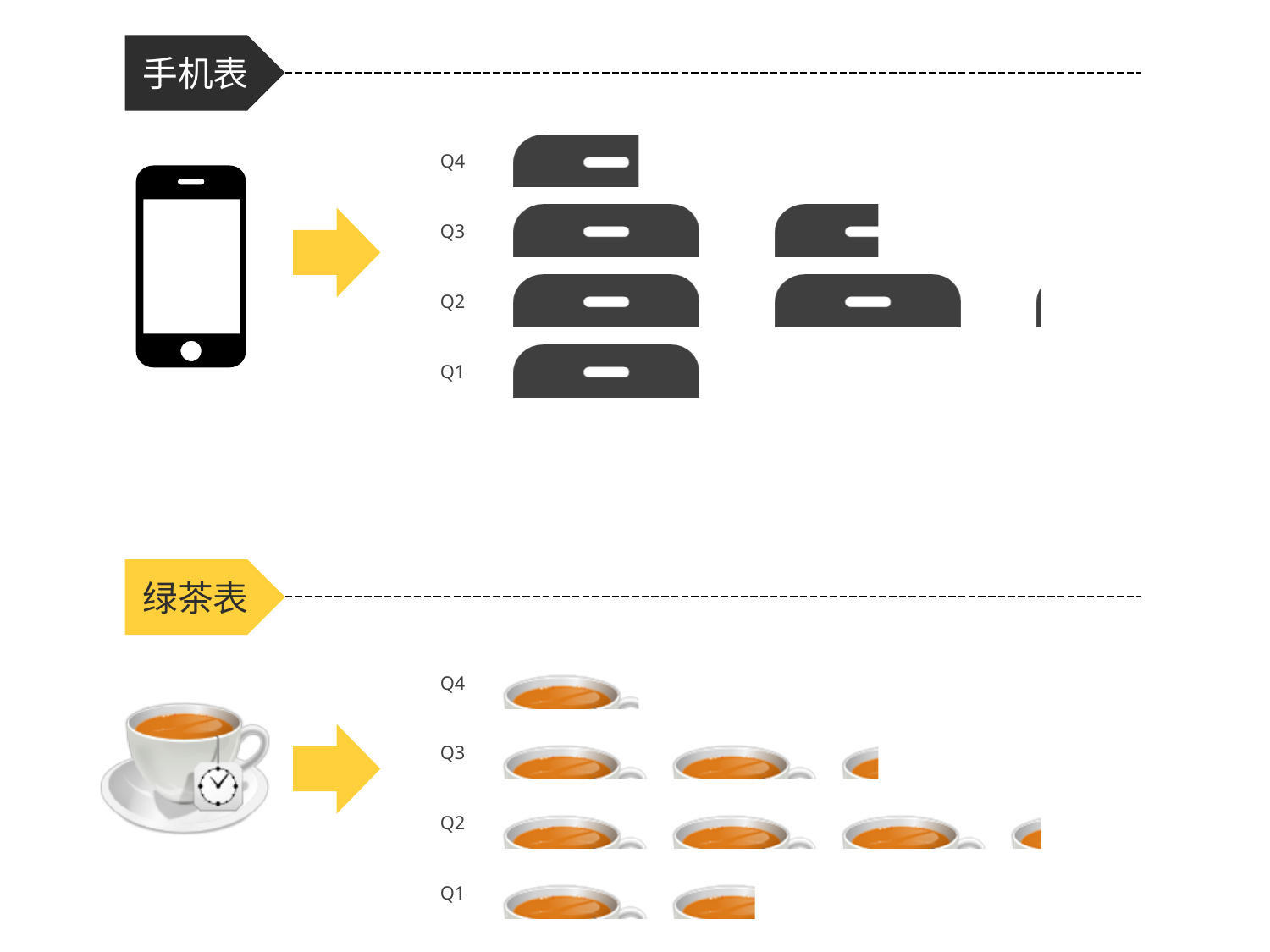
In the 手机表 chart, which quarter has the lowest value? Q4 In the 绿茶表 chart, which is larger, Q3 or Q1? Q3 What kind of chart is the 绿茶表 chart at the bottom of the slide? bar chart What is the title of the chart at the top of the slide? 手机表 In the 手机表 chart, which is larger, Q2 or Q4? Q2 In the 绿茶表 chart, which quarter has the lowest value? Q4 How many categories does the 绿茶表 chart show? 4 What kind of chart is the 手机表 chart at the top of the slide? bar chart In the 绿茶表 chart, which quarter has the highest value? Q2 How many categories does the 手机表 chart show? 4 In the 手机表 chart, which quarter has the highest value? Q2 In the 手机表 chart, which is larger, Q3 or Q1? Q3